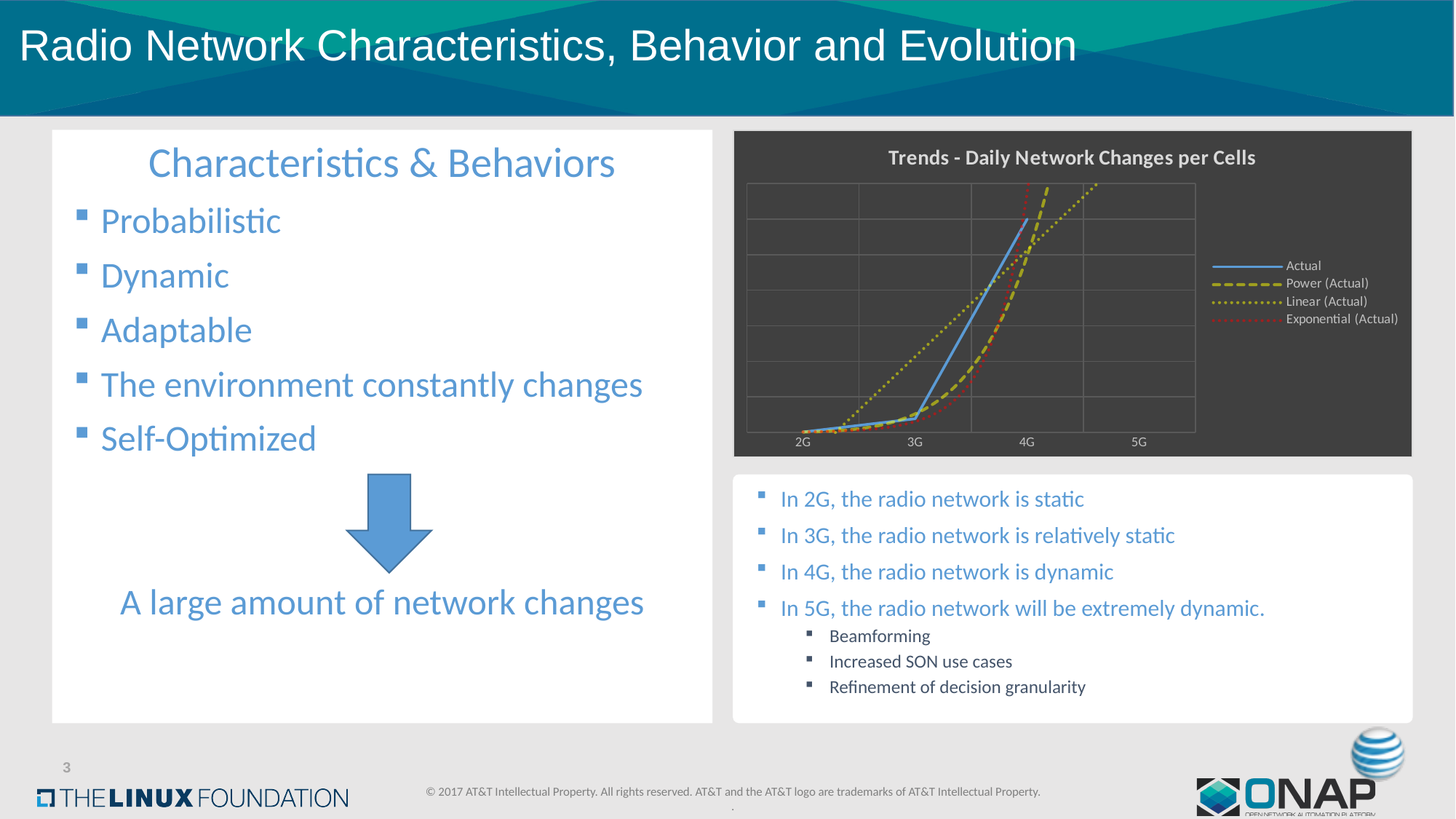
Is the Actual value larger at 4G or at 3G? 4G Which x-axis category has the lowest value for the Actual series? 2G What is the last category label on the x axis of the chart? 5G How many series does the chart's legend list? 4 How many categories are labelled on the x axis of the chart? 4 What is the title of the chart? Trends - Daily Network Changes per Cells Which x-axis category has the highest value for the Actual series? 4G What kind of chart is shown on the slide? line chart Does the Actual series rise or fall from 2G to 4G? rise Which legend entry is drawn as a solid blue line? Actual